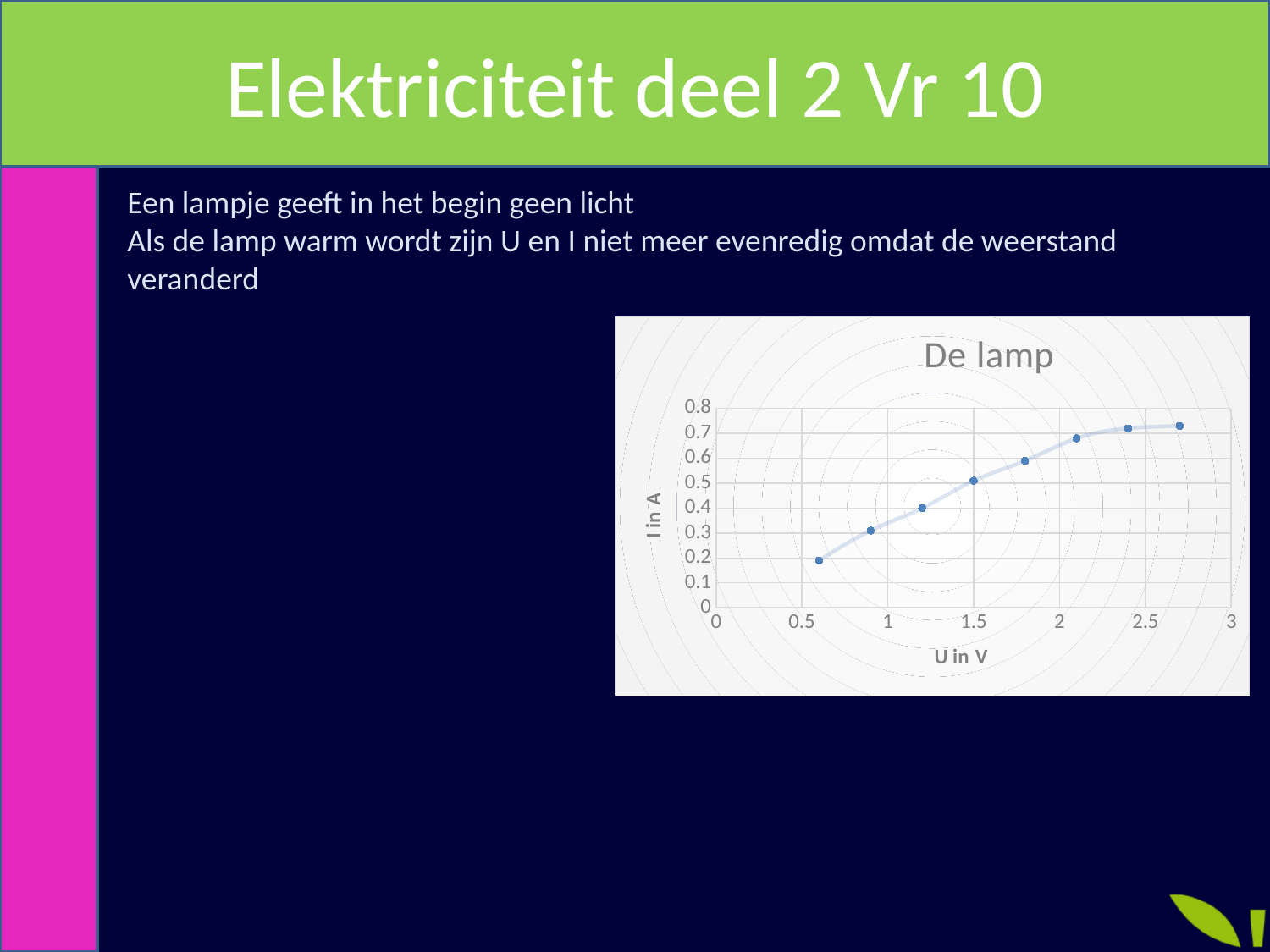
Does the current I rise or fall as the voltage U increases along the x axis? rises What is the title of the chart? De lamp Is the value of I at U = 2.4 V greater or less than 0.6? greater What kind of chart is shown on the slide? line chart Is the value of I at U = 0.6 V greater or less than 0.3? less Is the value of I at U = 1.8 V greater or less than 0.5? greater Which is larger: the current at U = 1.5 V or the current at U = 0.9 V? U = 1.5 V How many data points are plotted on the chart? 8 What is the label of the x axis of the chart? U in V